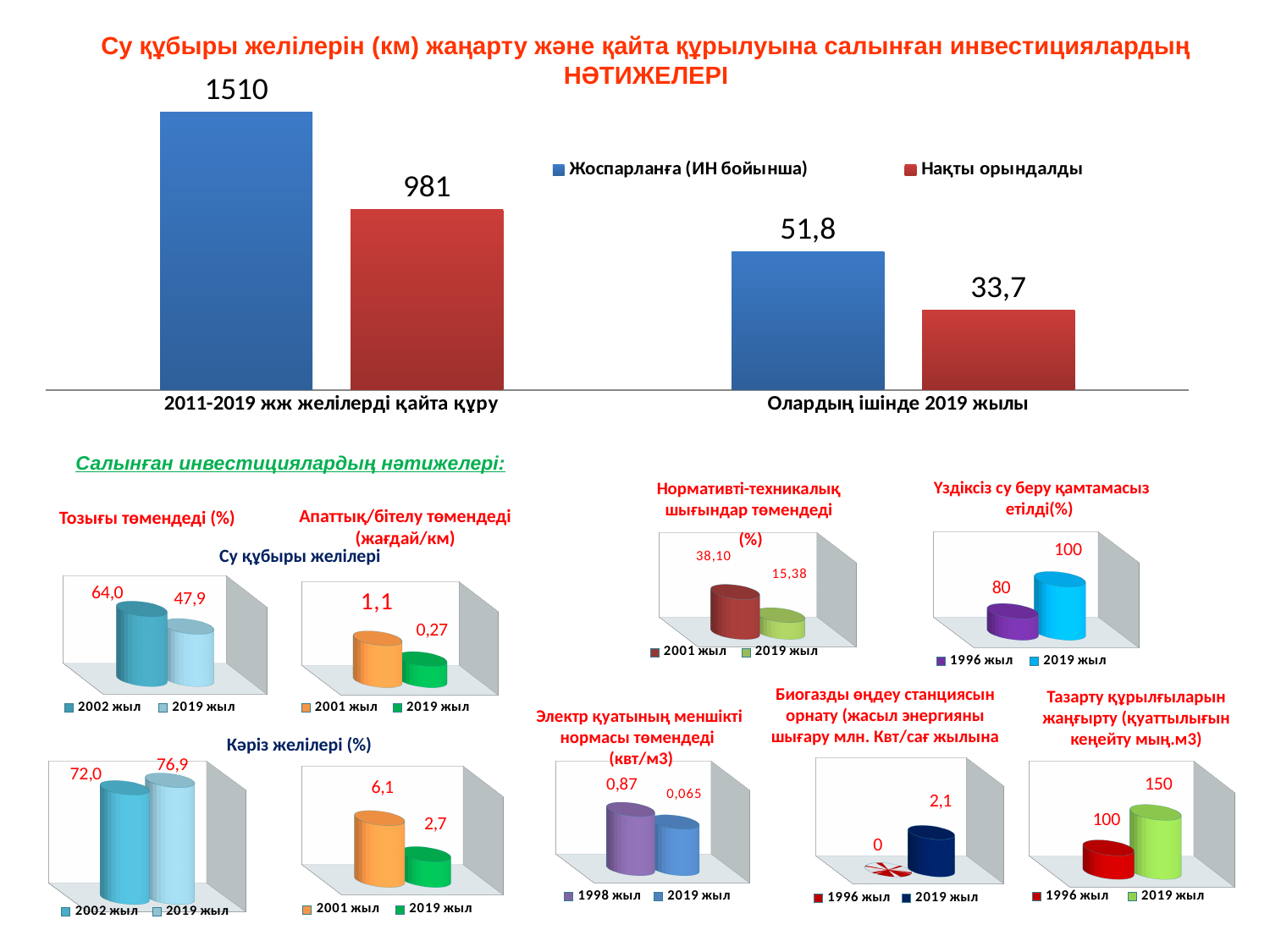
In the 'Үздіксіз су беру қамтамасыз етілді(%)' chart, what is the value for 1996 жыл? 80 What kind of chart is the top chart? Bar chart In the 'Тозығы төмендеді (%)' chart for 'Кәріз желілері', which year has the larger value, 2002 жыл or 2019 жыл? 2019 жыл In the top chart, what is the value of 'Жоспарланға (ИН бойынша)' for '2011-2019 жж желілерді қайта құру'? 1510 In the 'Тазарту құрылғыларын жаңғырту (қуаттылығын кеңейту мың.м3)' chart, what is the difference between the 2019 жыл and 1996 жыл values? 50 In the top chart, what is the value of 'Нақты орындалды' for 'Олардың ішінде 2019 жылы'? 33,7 In the top chart, what is the difference between the planned and actual values for '2011-2019 жж желілерді қайта құру'? 529 How many series does the legend of the top chart list? 2 In the 'Электр қуатының меншікті нормасы төмендеді (квт/м3)' chart, what is the value for 2019 жыл? 0,065 In the 'Тозығы төмендеді (%)' chart for 'Су құбыры желілері', what is the value for 2019 жыл? 47,9 In the 'Апаттық/бітелу төмендеді (жағдай/км)' chart for 'Кәріз желілері', what is the value for 2001 жыл? 6,1 In the 'Нормативті-техникалық шығындар төмендеді (%)' chart, what is the value for 2001 жыл? 38,10